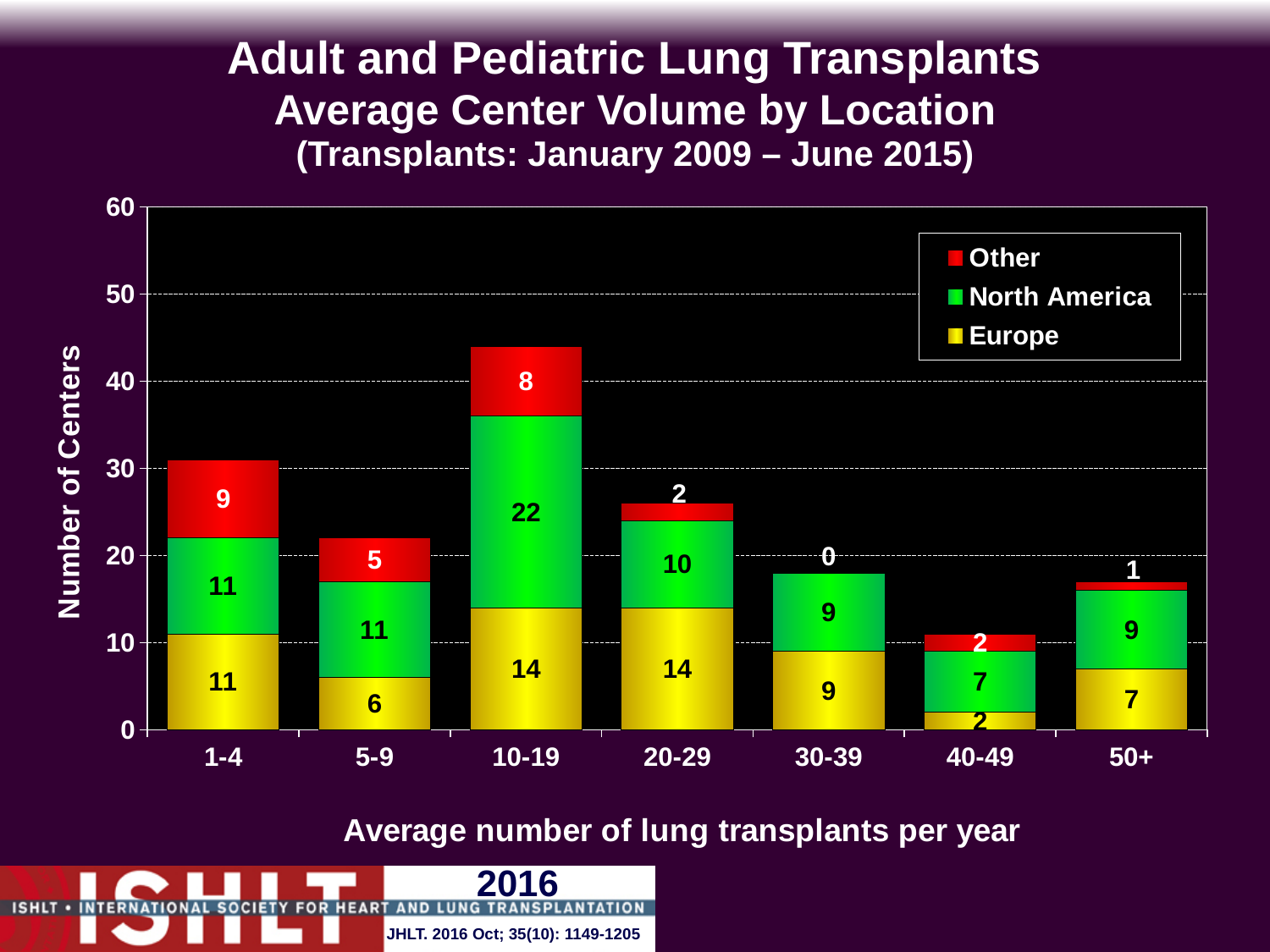
What is the difference between the North America value and the Europe value in the 10-19 category? 8 What is the number of Other centers in the 30-39 category? 0 Which is larger in the 20-29 category, the Europe value or the North America value? Europe Which category has the lowest total number of centers? 40-49 How many categories are shown on the x axis? 7 Which category has the highest total number of centers? 10-19 How many series does the legend list? 3 What is the total number of centers in the 1-4 category? 31 What type of chart is shown on the slide? Stacked bar chart What is the total number of centers in the 50+ category? 17 What is the number of North America centers in the 10-19 category? 22 What is the number of Europe centers in the 5-9 category? 6